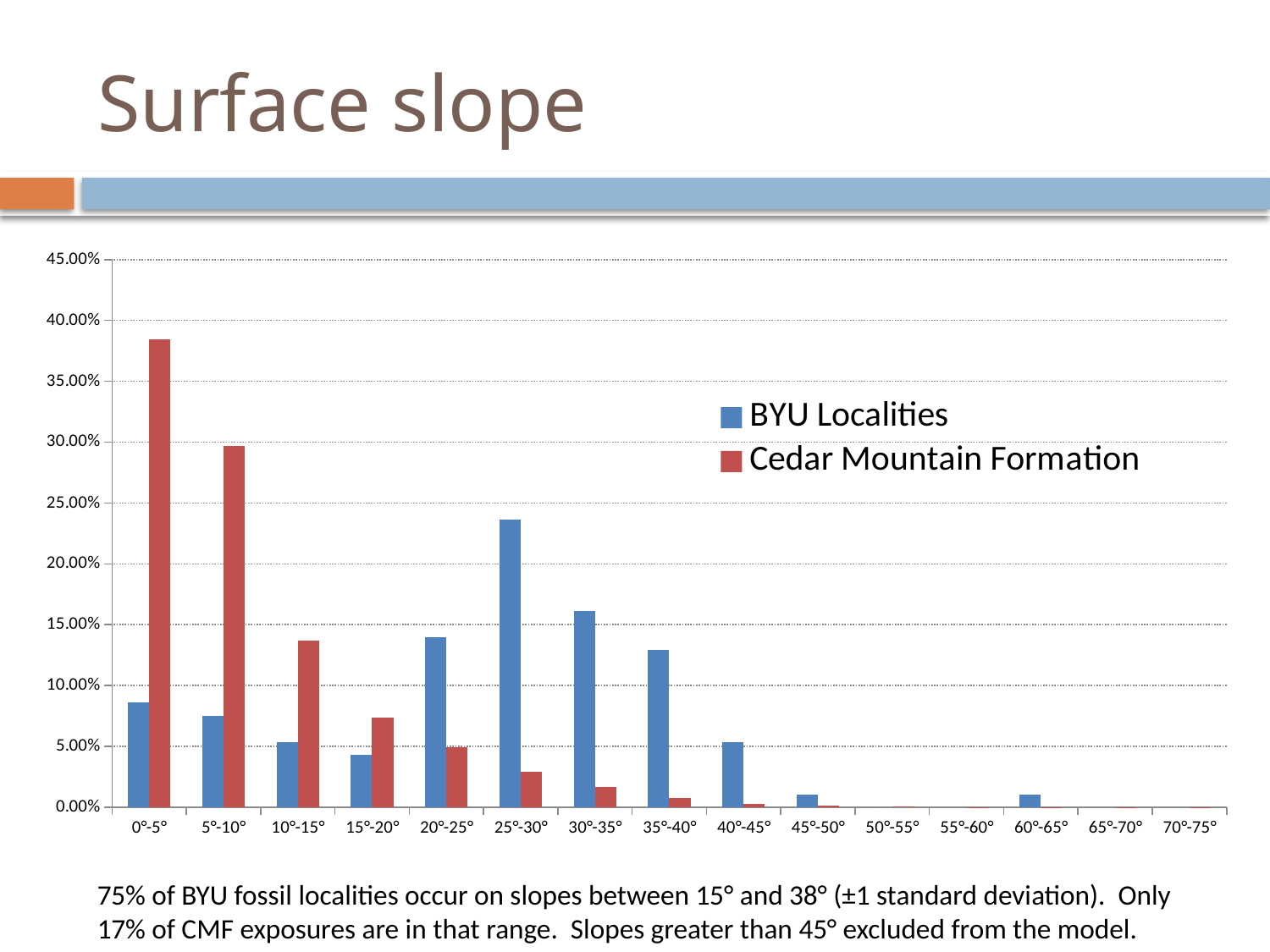
What kind of chart is shown on the slide? bar chart Is the Cedar Mountain Formation value for 10°-15° greater or less than 10.00%? greater For the 0°-5° category, which series has the larger value, BYU Localities or Cedar Mountain Formation? Cedar Mountain Formation For the 25°-30° category, which series has the larger value, BYU Localities or Cedar Mountain Formation? BYU Localities Is the Cedar Mountain Formation value for 0°-5° greater or less than 35.00%? greater Do the Cedar Mountain Formation values generally rise or fall as slope increases along the x axis? fall Is the BYU Localities value for 25°-30° greater or less than 20.00%? greater Which slope category has the highest value for Cedar Mountain Formation? 0°-5° How many series does the legend list? 2 Which slope category has the highest value for BYU Localities? 25°-30° How many slope categories are shown on the x axis? 15